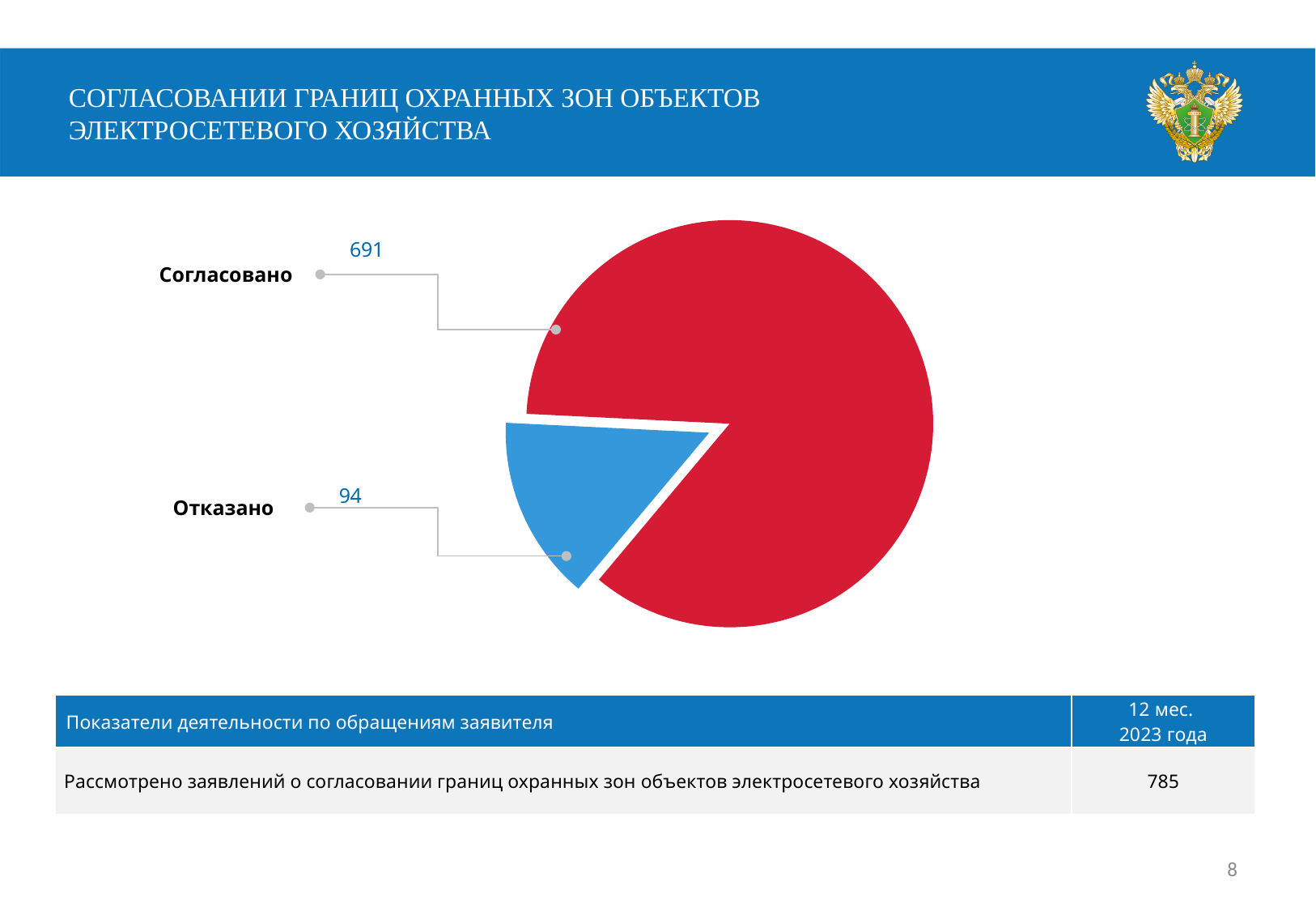
What colour is the Отказано slice in the pie chart? Blue How many slices does the pie chart have? 2 Which category has the smallest slice in the pie chart? Отказано What kind of chart is shown on the slide? Pie chart What is the value for Отказано in the pie chart? 94 What is the difference between the values for Согласовано and Отказано? 597 Which is larger, the value for Согласовано or the value for Отказано? Согласовано What is the total of the two values shown in the pie chart? 785 What is the value for Согласовано in the pie chart? 691 Which category has the largest slice in the pie chart? Согласовано